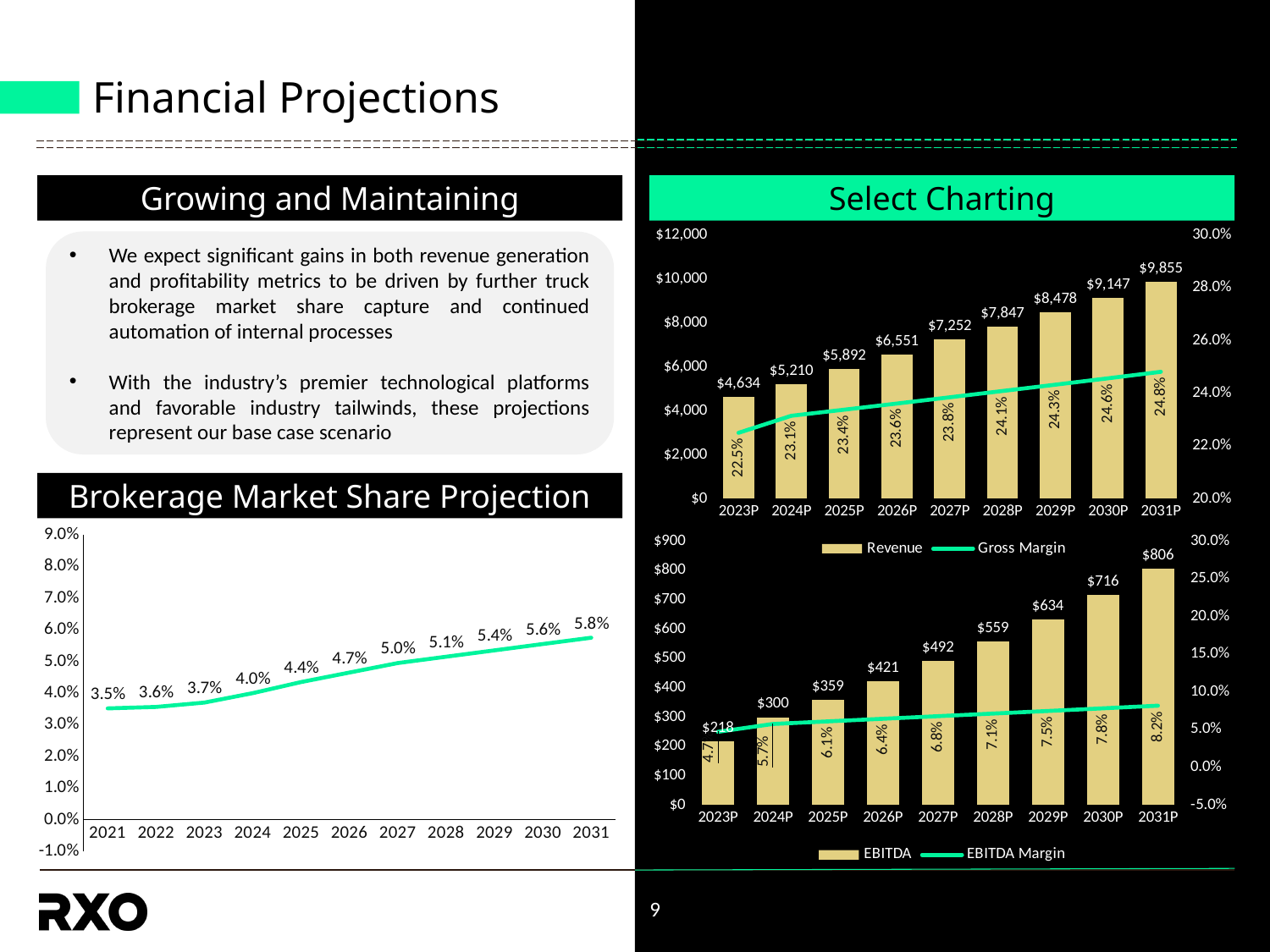
In the Brokerage Market Share Projection chart, what is the value for 2025? 4.4% How many series does the legend of the top-right chart under Select Charting list? 2 In the bottom-right chart under Select Charting, what is the difference between EBITDA in 2031P and EBITDA in 2030P? $90 In the top-right chart under Select Charting, what is the difference between Revenue in 2031P and Revenue in 2023P? $5,221 In the bottom-right chart under Select Charting, which year has the lowest EBITDA Margin? 2023P In the top-right chart under Select Charting, what is the Revenue value for 2027P? $7,252 In the Brokerage Market Share Projection chart, do the values rise or fall from 2021 to 2031? Rise In the top-right chart under Select Charting, what is the Gross Margin for 2029P? 24.3% How many years are plotted in the Brokerage Market Share Projection chart? 11 In the Brokerage Market Share Projection chart, which year has the highest value? 2031 What kind of chart is the Brokerage Market Share Projection chart? Line chart In the bottom-right chart under Select Charting, what is the EBITDA value for 2026P? $421